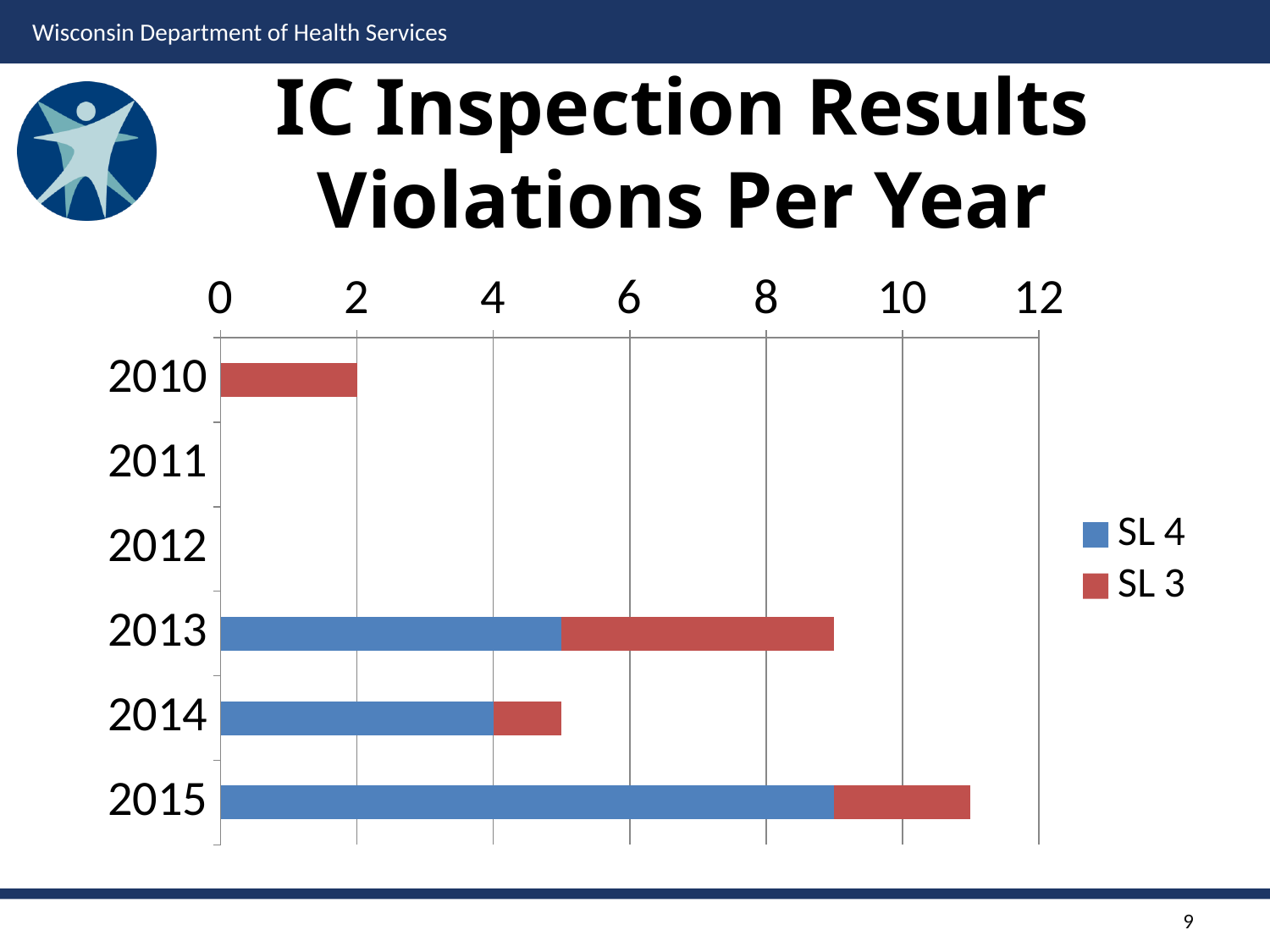
Which colour represents SL 3 in the legend? Red How many years are shown on the vertical axis? 6 Which years show no violations at all? 2011 and 2012 Is the total bar for 2013 greater or less than 8? greater How many series does the legend list? 2 What kind of chart is shown on the slide? Stacked bar chart What is the SL 3 value for 2010? 2 Which year has the larger total bar, 2013 or 2014? 2013 Is the SL 4 value for 2015 greater or less than 8? greater What is the SL 4 value for 2014? 4 Which year has the longest total bar? 2015 Is the total bar for 2015 greater or less than 10? greater